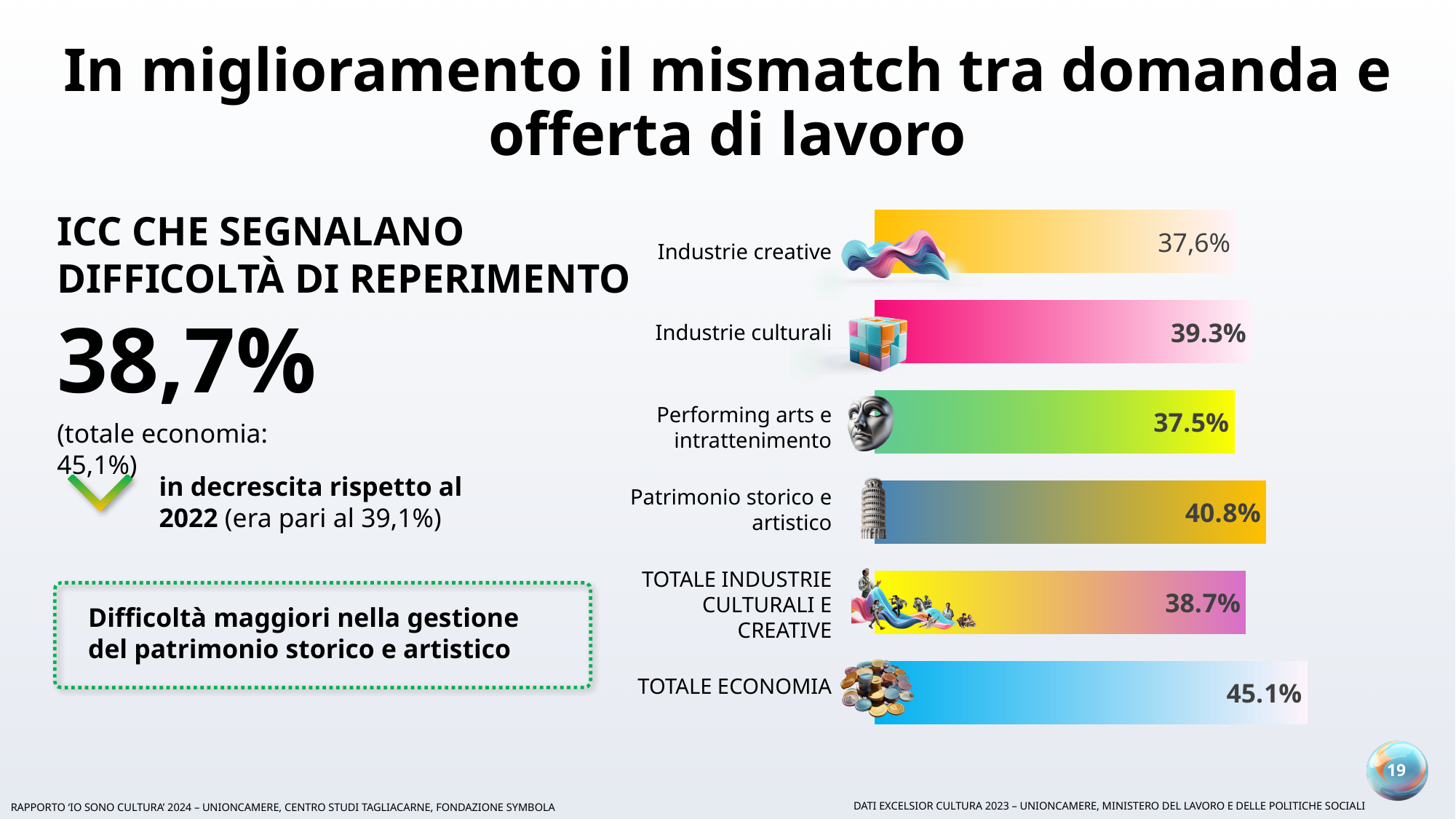
What is the value shown for Industrie creative? 37,6% How many categories are shown in the bar chart? 6 What kind of chart is shown on the slide? Bar chart Which category has the highest value in the chart? TOTALE ECONOMIA What is the difference between the value for TOTALE ECONOMIA and the value for TOTALE INDUSTRIE CULTURALI E CREATIVE? 6.4 percentage points What is the value shown for TOTALE ECONOMIA? 45.1% What is the value shown for Patrimonio storico e artistico? 40.8% What is the value shown for Industrie culturali? 39.3% Which is larger, the value for Patrimonio storico e artistico or the value for Industrie culturali? Patrimonio storico e artistico What is the value shown for TOTALE INDUSTRIE CULTURALI E CREATIVE? 38.7% What is the value shown for Performing arts e intrattenimento? 37.5% Which category has the lowest value in the chart? Performing arts e intrattenimento